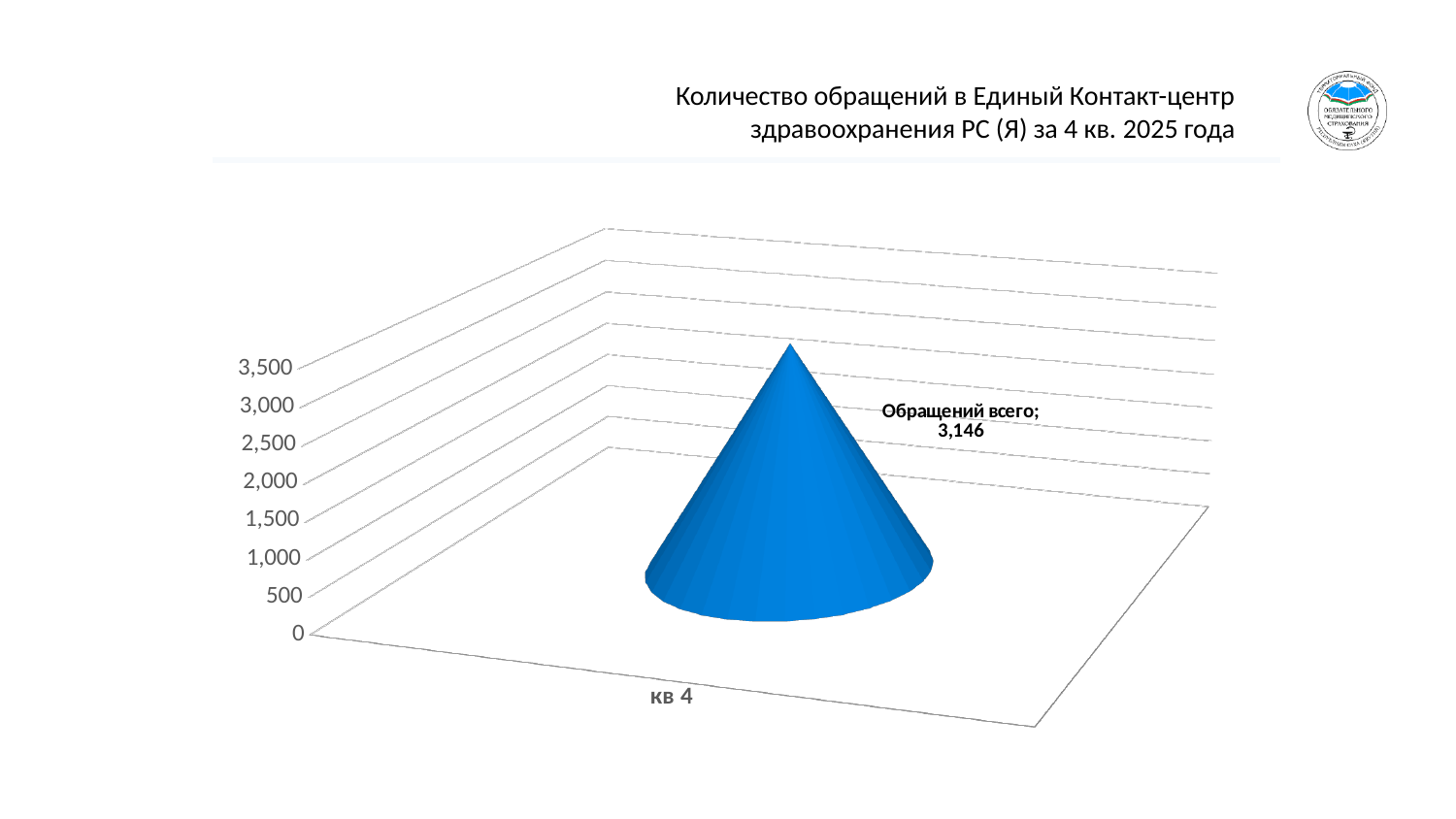
What is the label of the only category on the x axis? кв 4 What is the highest tick value shown on the vertical axis of the chart? 3,500 Is the value for кв 4 greater or less than 3,500? less Is the value for кв 4 greater or less than 3,000? greater What is the value of the series Обращений всего for кв 4? 3,146 What kind of chart is shown on the slide? 3D cone chart How many categories are plotted on the x axis of the chart? 1 What is the value for кв 4 in the chart? 3,146